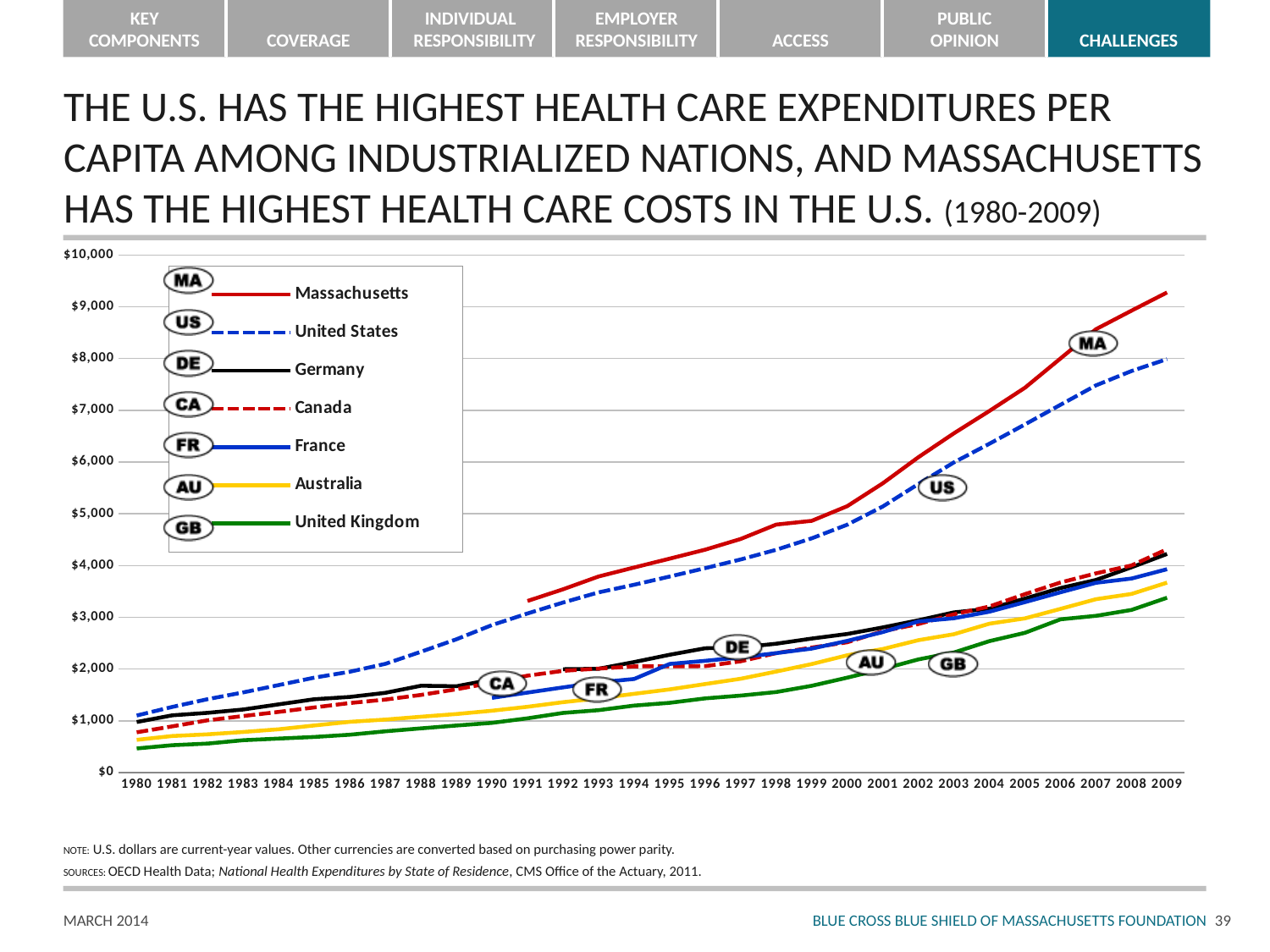
How many years are shown along the x axis? 30 Is the value for Australia in 2009 greater or less than $4,000? less Which series has the lowest value in 2009? United Kingdom How many series does the legend list? 7 Which series is drawn as a dashed blue line? United States Which series has the highest value in 2009? Massachusetts Do the values for the United States rise or fall from 1980 to 2009? Rise In 2009, which is larger: the value for Australia or the value for the United Kingdom? Australia Is the value for Massachusetts in 2009 greater or less than $9,000? greater In 2009, which is larger: the value for Massachusetts or the value for the United States? Massachusetts Is the value for the United Kingdom in 1980 greater or less than $1,000? less What kind of chart is shown on the slide? Line chart